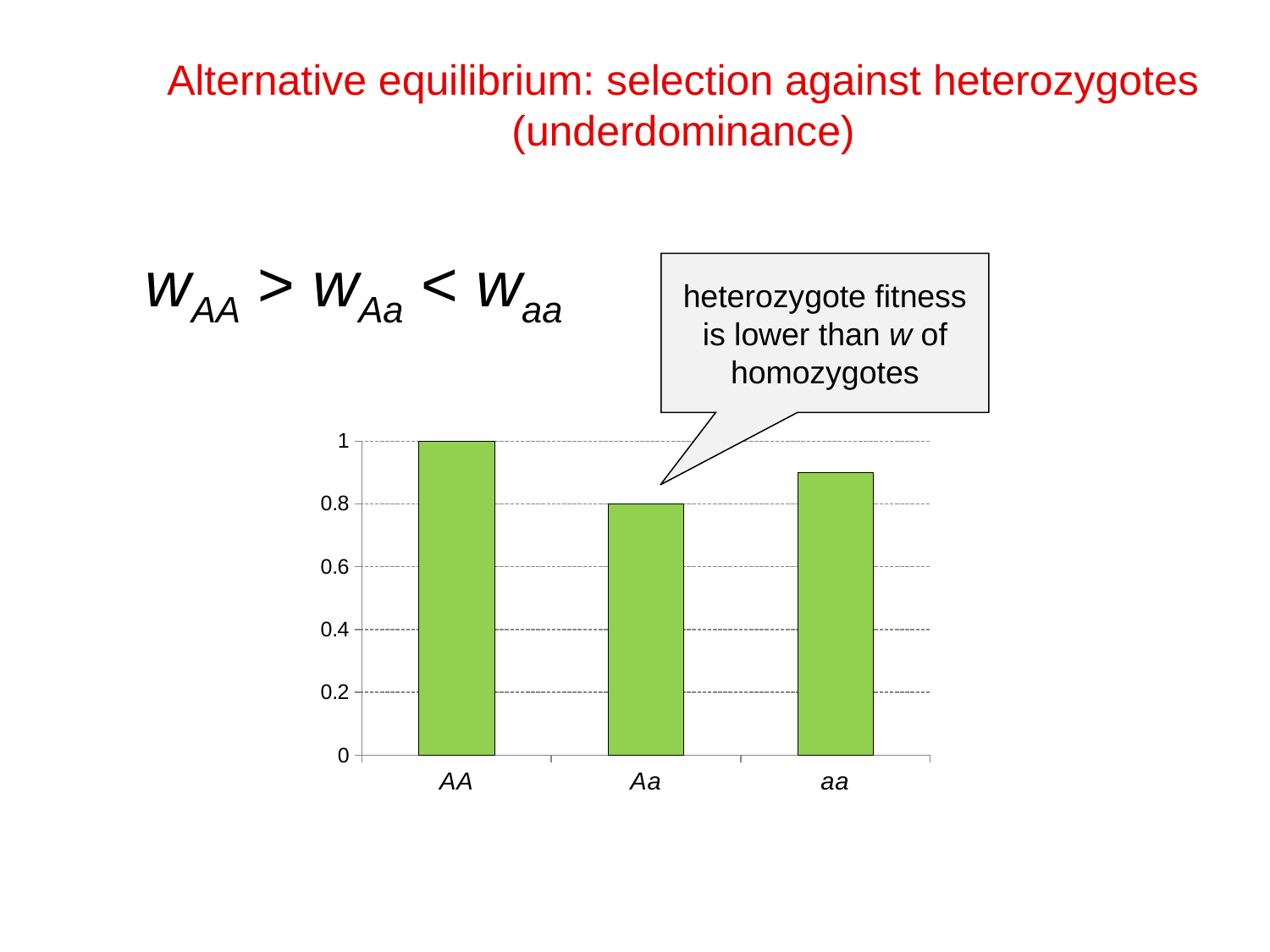
How many categories are shown on the x axis of the chart? 3 Is the value for aa greater or less than 0.8? greater What is the difference between the values for AA and Aa? 0.2 Is the value for aa greater or less than 1? less What kind of chart is shown on the slide? bar chart What is the value for AA in the chart? 1 Which category has the lowest bar in the chart? Aa What colour are the bars in the chart? green Which is larger, the value for AA or the value for aa? AA Which category has the highest bar in the chart? AA